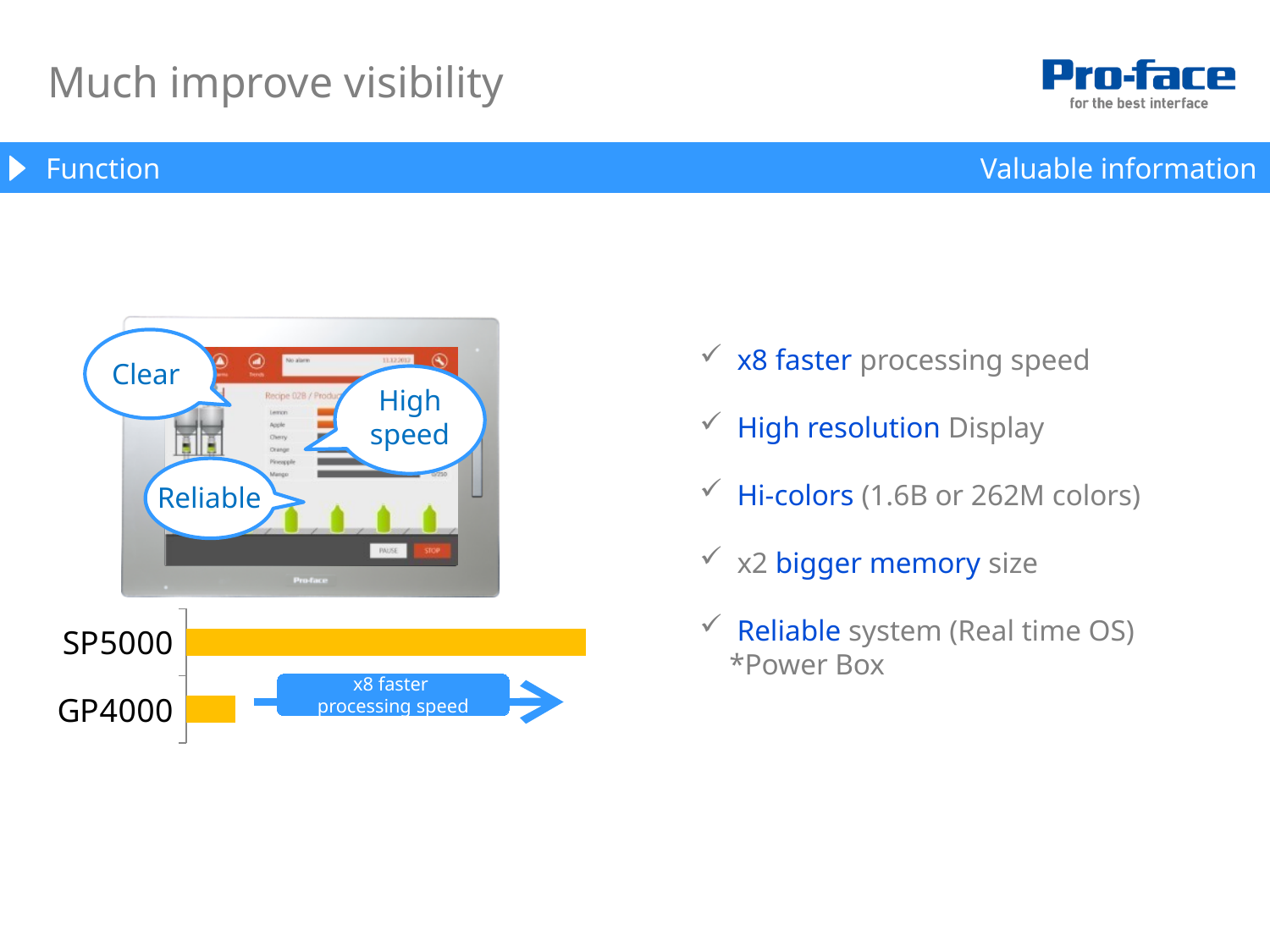
Which category has the shortest bar in the bar chart at the bottom left of the slide? GP4000 How many categories does the bar chart at the bottom left of the slide show? 2 Which category has the longest bar in the bar chart at the bottom left of the slide? SP5000 What does the annotation on the bar chart at the bottom left of the slide say? x8 faster processing speed What kind of chart is shown at the bottom left of the slide? bar chart Are the bars in the chart at the bottom left of the slide horizontal or vertical? horizontal In the bar chart at the bottom left of the slide, is the bar for SP5000 longer or shorter than the bar for GP4000? longer